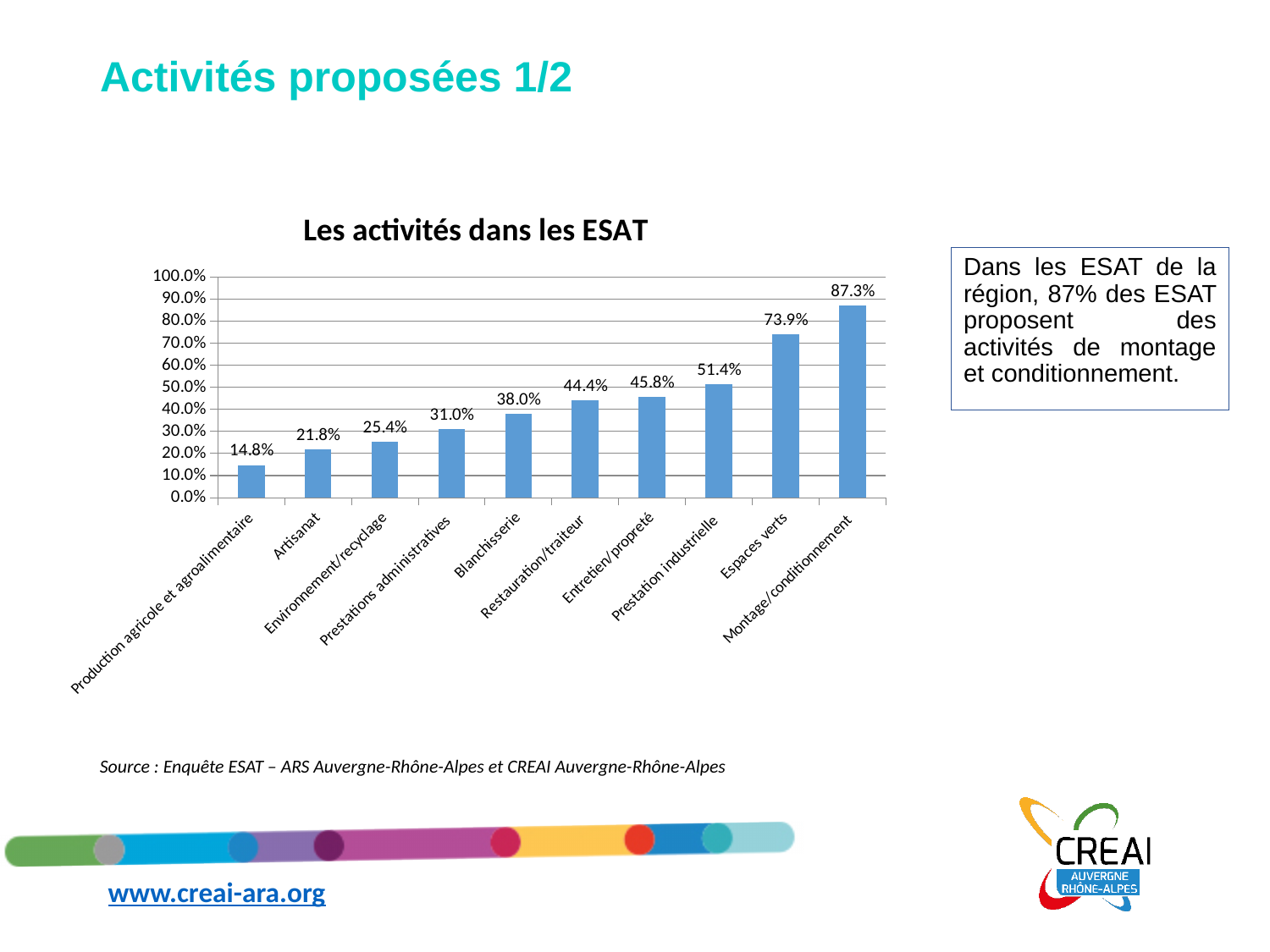
What is the value for Artisanat? 21.8% Which category has the highest value? Montage/conditionnement Do the values rise or fall from left to right along the x axis? Rise What is the difference between the values for Montage/conditionnement and Espaces verts? 13.4% What is the value for Blanchisserie? 38.0% What kind of chart is shown? Bar chart Is the value for Prestation industrielle greater or less than 50.0%? greater Which category has the lowest value? Production agricole et agroalimentaire How many categories are shown on the x axis? 10 What is the title of the chart? Les activités dans les ESAT What is the value for Espaces verts? 73.9% Which is larger, the value for Restauration/traiteur or the value for Entretien/propreté? Entretien/propreté